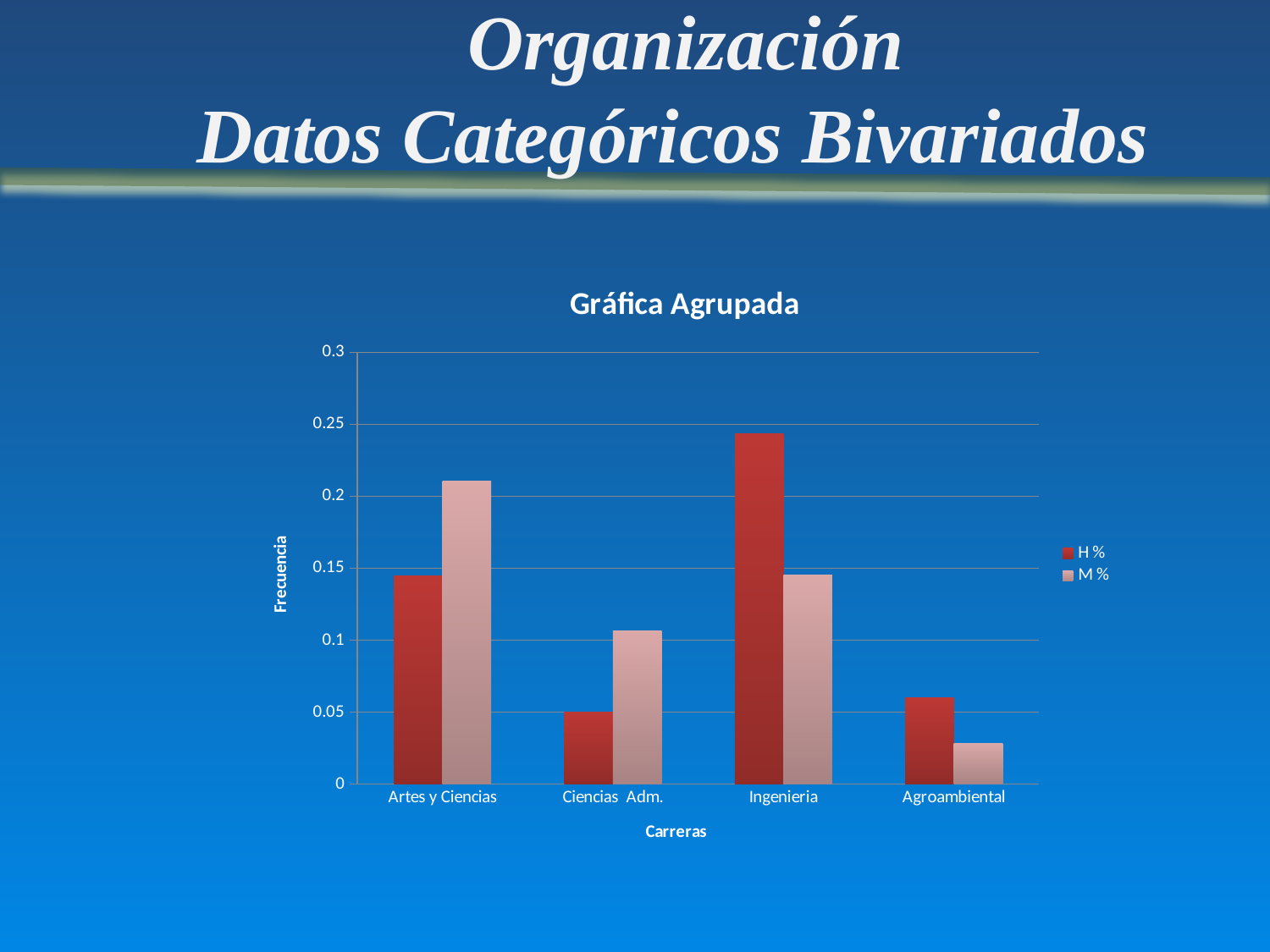
How many categories (carreras) are shown on the x axis? 4 How many series does the legend list? 2 Which carrera has the highest value for the H % series? Ingenieria What is the title of the chart? Gráfica Agrupada For Artes y Ciencias, which series has the larger value, H % or M %? M % What kind of chart is shown on the slide? Bar chart Which carrera has the highest value for the M % series? Artes y Ciencias For Ingenieria, which series has the larger value, H % or M %? H % Which carrera has the lowest value for the H % series? Ciencias Adm. Is the M % value for Agroambiental greater or less than 0.05? less Which carrera has the lowest value for the M % series? Agroambiental Is the H % value for Ingenieria greater or less than 0.2? greater